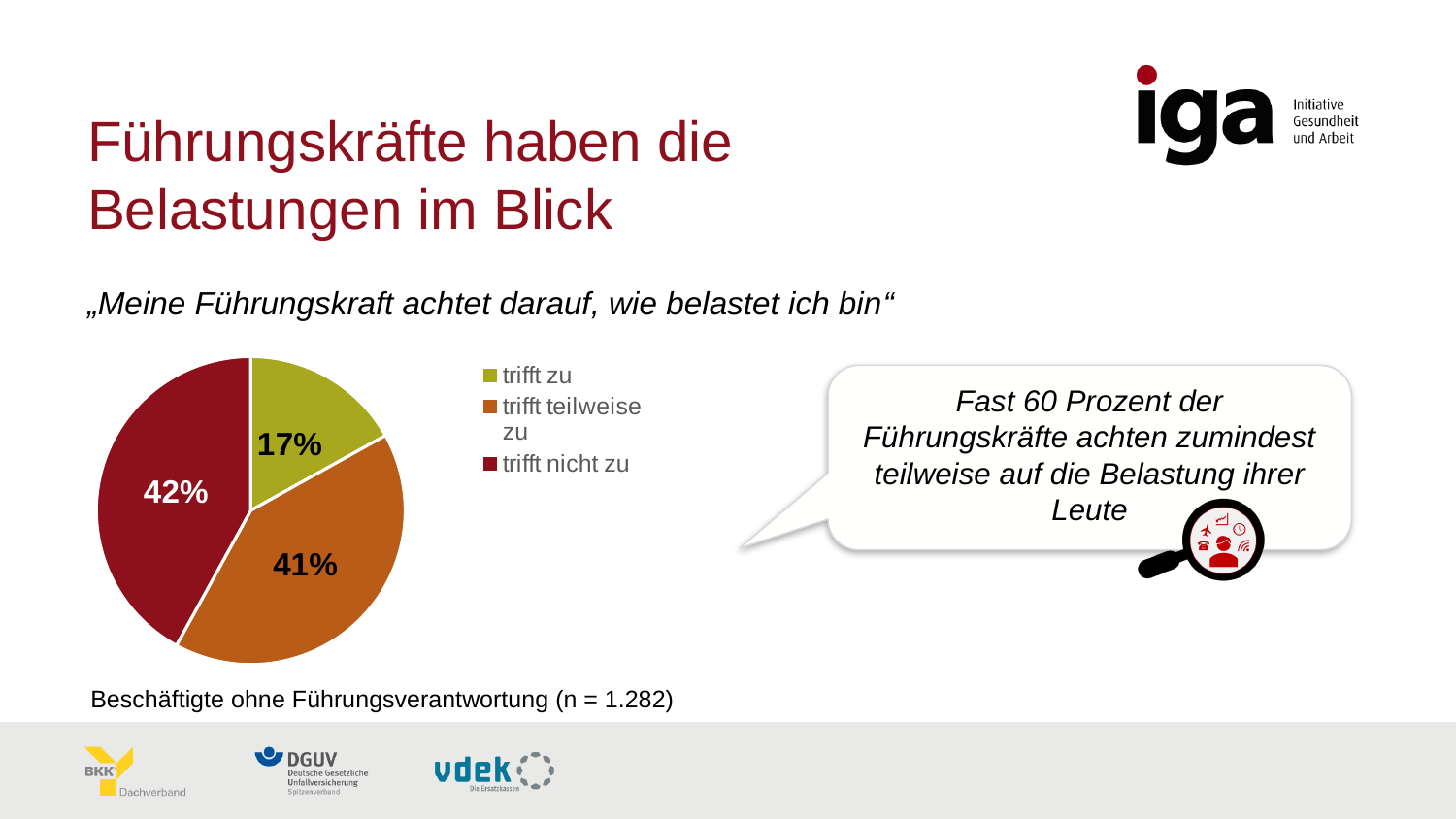
What type of chart is shown on the slide? Pie chart Which response category has the smallest share of the pie? trifft zu How many slices does the pie chart have? 3 What is the difference in percentage points between "trifft teilweise zu" and "trifft zu"? 24 percentage points What colour is the slice for "trifft nicht zu"? Dark red What share of respondents answered "trifft zu"? 17% How many entries does the legend list? 3 What share of respondents answered "trifft nicht zu"? 42% Which response category has the largest share of the pie? trifft nicht zu Which is larger, the share for "trifft teilweise zu" or the share for "trifft zu"? trifft teilweise zu What share of respondents answered "trifft teilweise zu"? 41% What is the difference in percentage points between "trifft nicht zu" and "trifft zu"? 25 percentage points